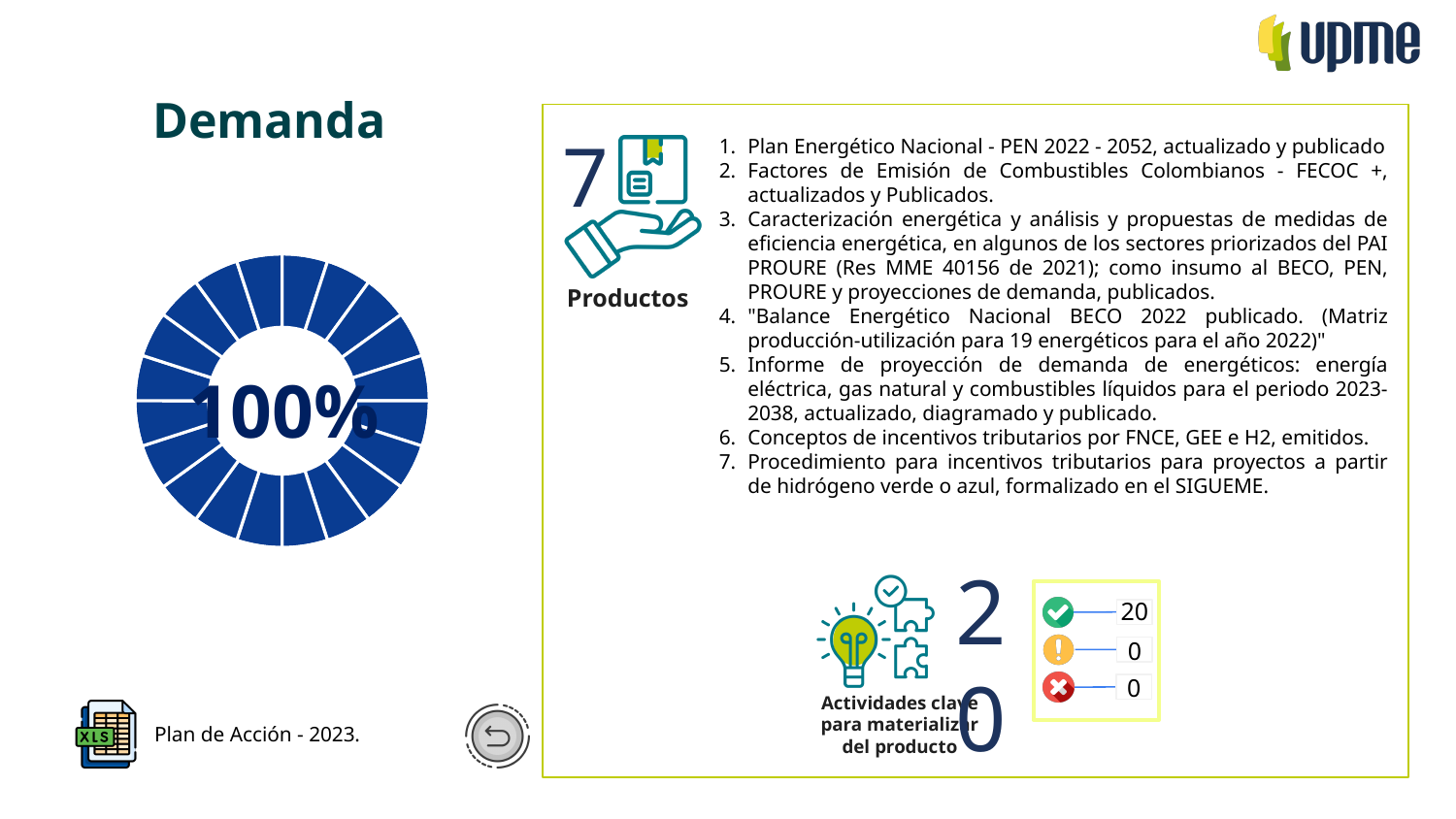
Does the doughnut chart show a completion value of 100%? yes What is the title of the slide containing the doughnut chart? Demanda What colour are the segments of the doughnut chart? blue What kind of chart is shown on the left side of the slide? doughnut chart What percentage is displayed in the center of the doughnut chart? 100%